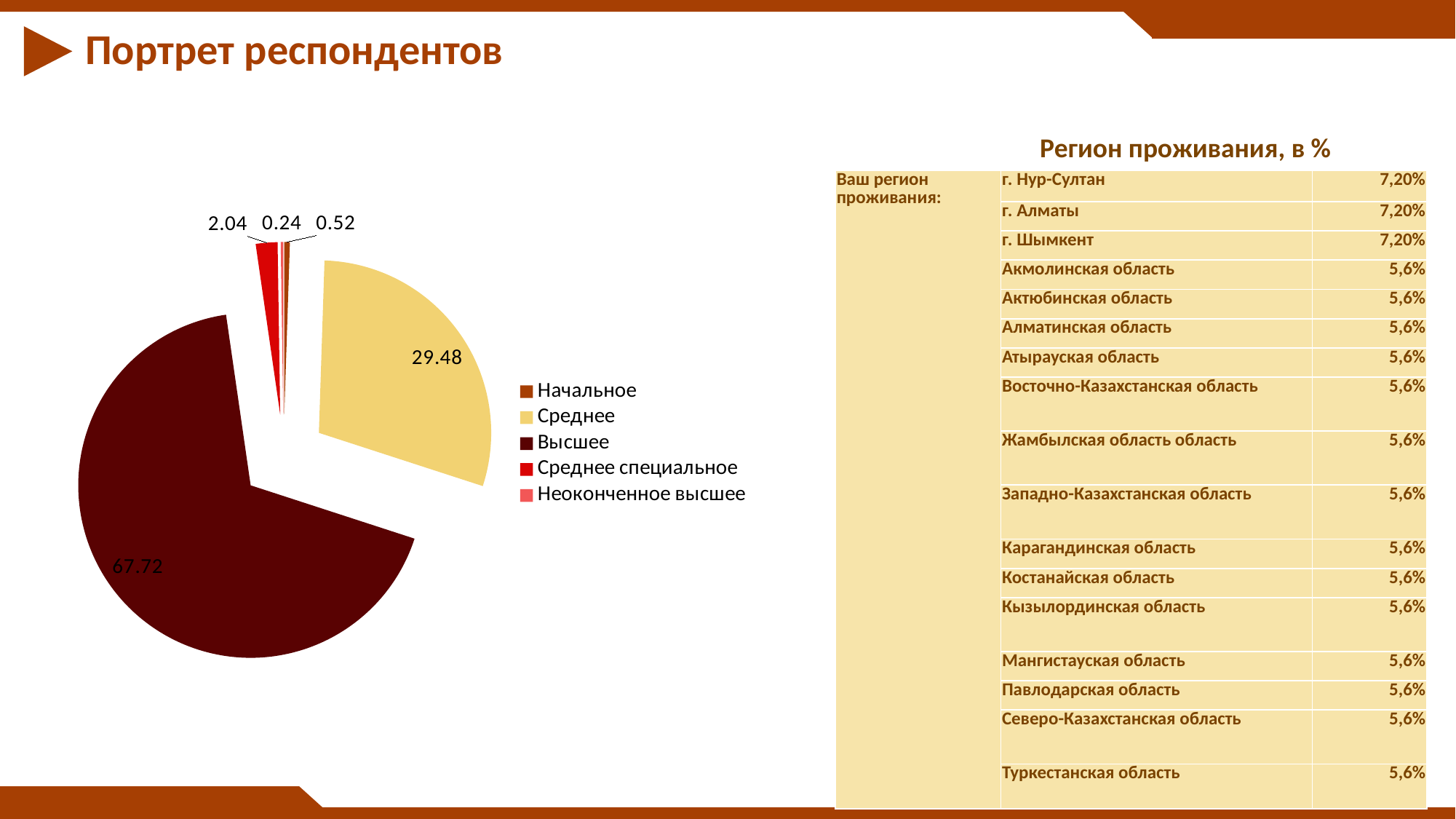
How many categories does the legend of the pie chart list? 5 Is the value for Высшее in the pie chart greater or less than 50? greater Which category has the largest slice in the pie chart? Высшее Which legend entry in the pie chart is shown in yellow? Среднее What is the difference between the values for Высшее and Среднее in the pie chart? 38.24 What is the value shown for Среднее специальное in the pie chart? 2.04 What kind of chart is shown on the left of the slide? pie chart How many slices does the pie chart have? 5 What is the value shown for Среднее in the pie chart? 29.48 Which is larger in the pie chart, Среднее or Высшее? Высшее Which legend entry in the pie chart is shown in dark maroon? Высшее What is the value shown for Высшее in the pie chart? 67.72